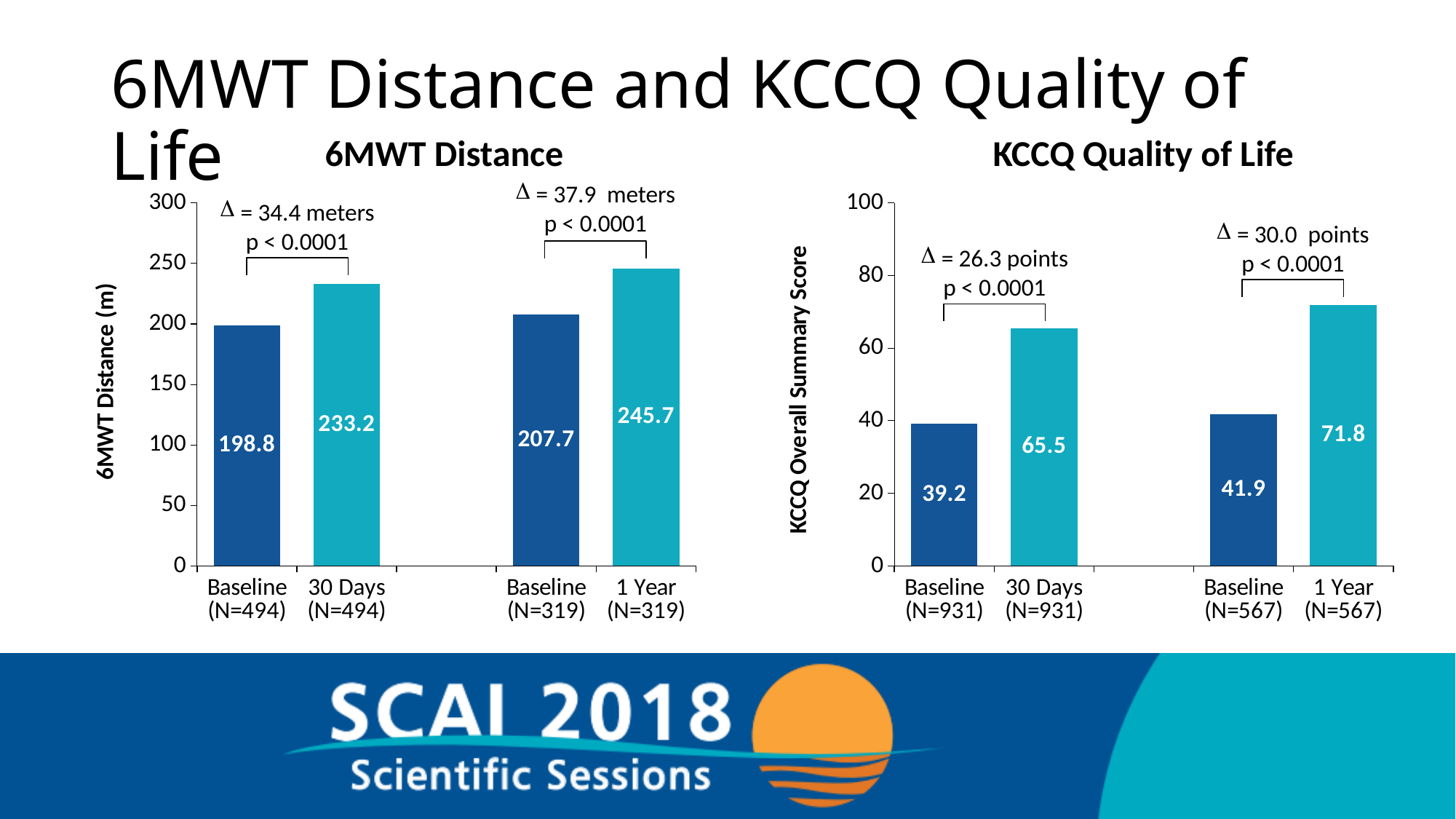
What kind of chart is the 6MWT Distance chart? Bar chart In the KCCQ Quality of Life chart, which is larger: the 30 Days (N=931) value or the 1 Year (N=567) value? 1 Year (N=567) In the 6MWT Distance chart, what is the value for Baseline (N=494)? 198.8 In the 6MWT Distance chart, what is the value for 1 Year (N=319)? 245.7 In the KCCQ Quality of Life chart, what is the value for Baseline (N=567)? 41.9 In the 6MWT Distance chart, which bar has the highest value? 1 Year (N=319) In the KCCQ Quality of Life chart, what is the value for 30 Days (N=931)? 65.5 In the KCCQ Quality of Life chart, what is the difference between the 1 Year (N=567) value and the Baseline (N=567) value? 29.9 In the 6MWT Distance chart, what is the difference between the 30 Days (N=494) value and the Baseline (N=494) value? 34.4 How many bars are plotted in the KCCQ Quality of Life chart? 4 In the 6MWT Distance chart, is the value for Baseline (N=319) greater or less than 200? greater In the KCCQ Quality of Life chart, which bar has the lowest value? Baseline (N=931)